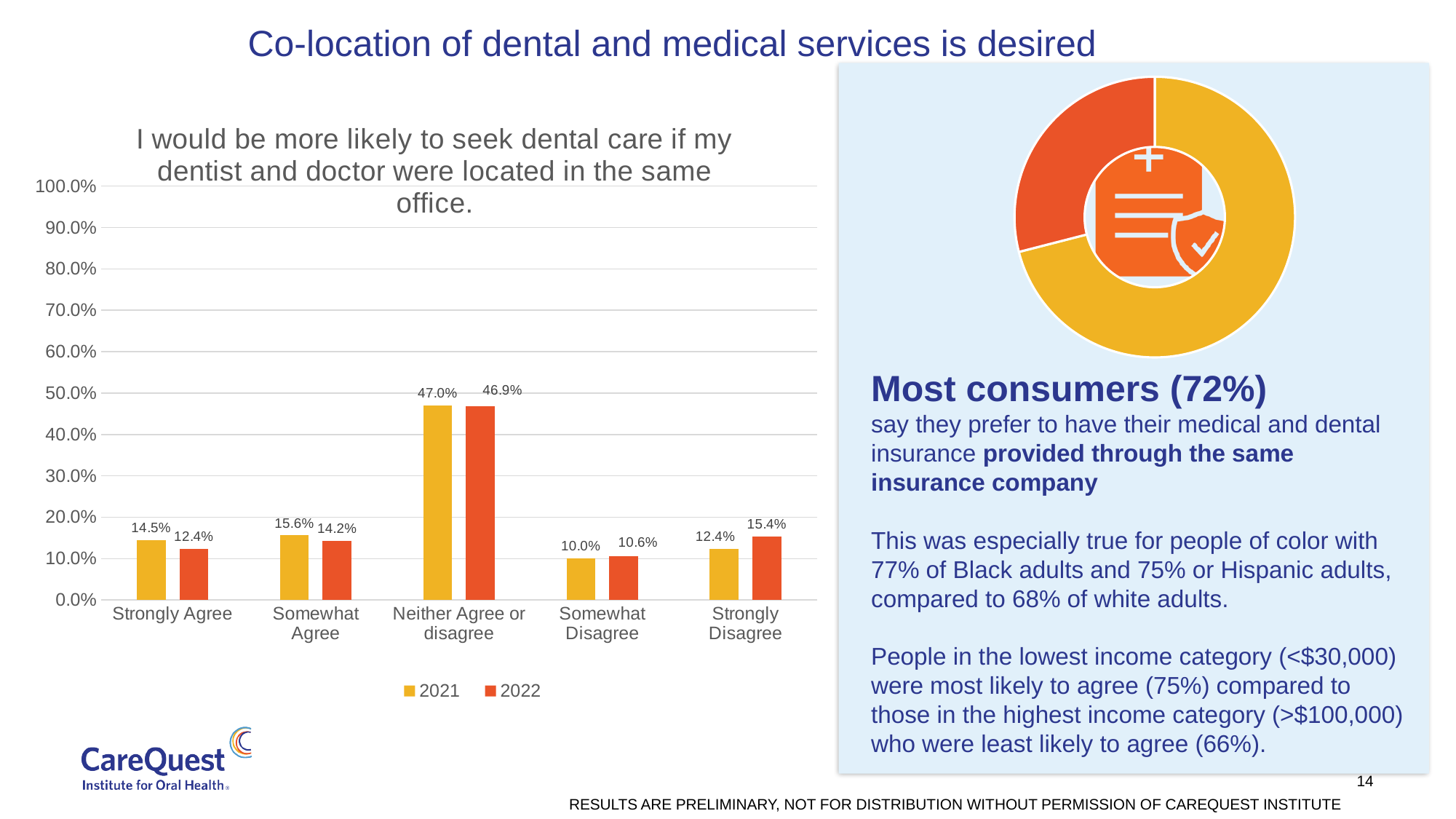
What is the difference between the 2021 and 2022 values for Strongly Disagree? 3.0% How many series does the legend of the bar chart list? 2 What is the 2022 value for Neither Agree or disagree? 46.9% Is the 2021 value for Neither Agree or disagree greater or less than 40.0%? greater How many response categories are shown on the x axis of the bar chart? 5 What is the 2022 value for Strongly Disagree? 15.4% Which category has the highest 2021 value? Neither Agree or disagree What type of chart is used to show the survey responses on the left of the slide? Bar chart What is the difference between the 2021 values for Somewhat Agree and Strongly Agree? 1.1% Which category has the lowest 2022 value? Somewhat Disagree Which is larger for Somewhat Disagree, the 2021 value or the 2022 value? 2022 What is the 2021 value for Strongly Agree? 14.5%